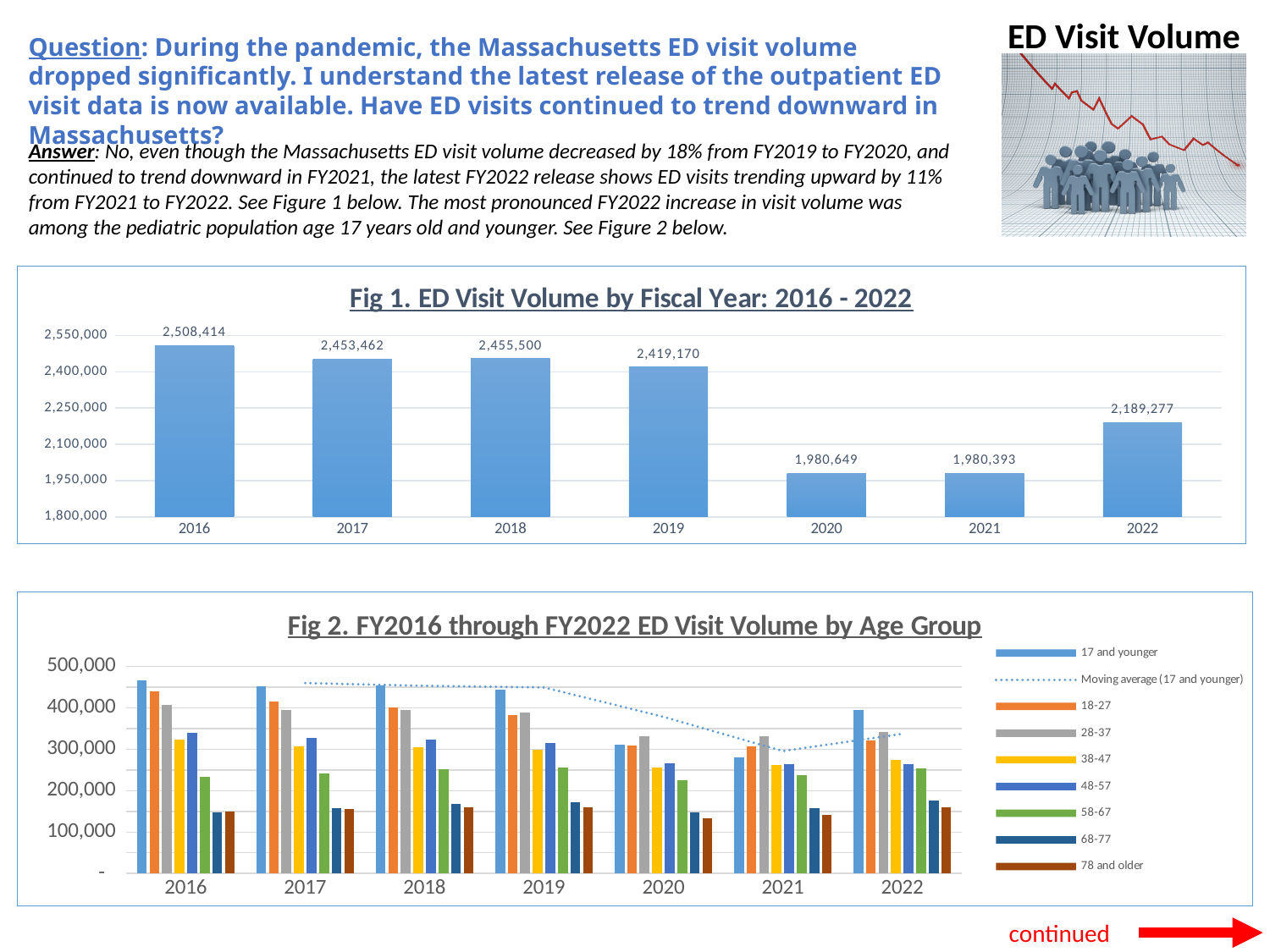
In Fig 1. ED Visit Volume by Fiscal Year, what is the difference between the 2019 and 2020 ED visit volumes? 438,521 In Fig 1. ED Visit Volume by Fiscal Year, how many fiscal years are plotted? 7 In Fig 2. FY2016 through FY2022 ED Visit Volume by Age Group, is the value for the 17 and younger group in 2016 greater or less than 400,000? greater In Fig 1. ED Visit Volume by Fiscal Year, what is the ED visit volume for 2016? 2,508,414 In Fig 2. FY2016 through FY2022 ED Visit Volume by Age Group, which legend entry is drawn as a dotted line rather than bars? Moving average (17 and younger) In Fig 1. ED Visit Volume by Fiscal Year, do the values rise or fall from 2016 to 2019? fall In Fig 2. FY2016 through FY2022 ED Visit Volume by Age Group, how many entries does the legend list? 9 In Fig 1. ED Visit Volume by Fiscal Year, what is the ED visit volume for 2022? 2,189,277 In Fig 1. ED Visit Volume by Fiscal Year, by how much did the ED visit volume increase from 2021 to 2022? 208,884 In Fig 1. ED Visit Volume by Fiscal Year, which fiscal year has the highest ED visit volume? 2016 What kind of chart is Fig 1. ED Visit Volume by Fiscal Year? bar chart In Fig 2. FY2016 through FY2022 ED Visit Volume by Age Group, is the value for the 78 and older group in 2020 greater or less than 200,000? less